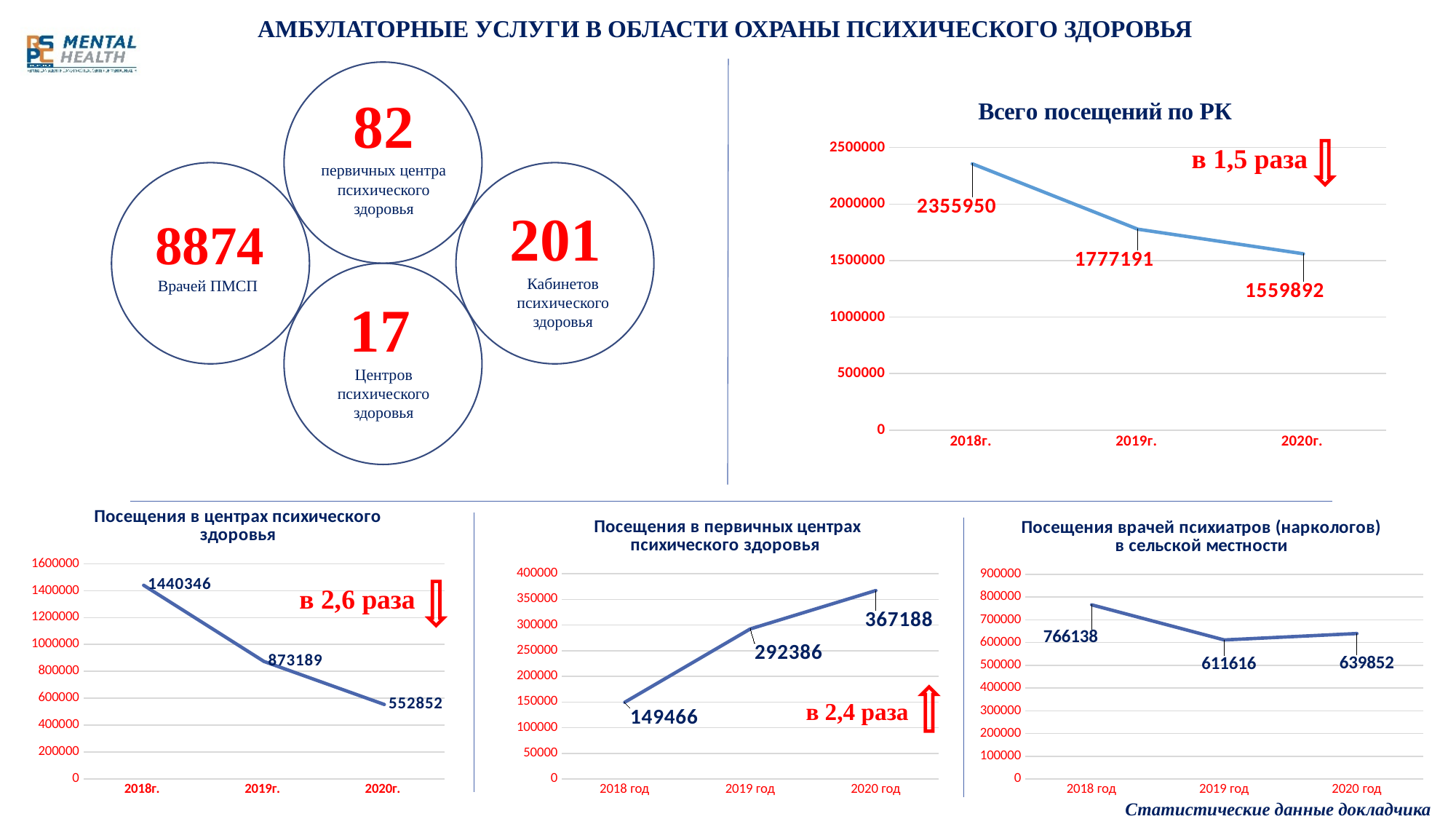
In the chart 'Всего посещений по РК', what is the value for 2018г.? 2355950 In the chart 'Посещения в центрах психического здоровья', what is the value for 2019г.? 873189 In the chart 'Всего посещений по РК', what is the value for 2020г.? 1559892 What kind of chart is 'Всего посещений по РК'? line chart In the chart 'Посещения в центрах психического здоровья', which year has the lowest value? 2020г. In the chart 'Посещения врачей психиатров (наркологов) в сельской местности', which is larger: the value for 2019 год or 2020 год? 2020 год In the chart 'Посещения в первичных центрах психического здоровья', what is the value for 2018 год? 149466 In the chart 'Посещения в первичных центрах психического здоровья', what is the difference between the 2020 год and 2018 год values? 217722 In the chart 'Всего посещений по РК', what is the difference between the 2018г. and 2020г. values? 796058 In the chart 'Посещения в первичных центрах психического здоровья', do the values rise or fall from 2018 год to 2020 год? rise In the chart 'Посещения врачей психиатров (наркологов) в сельской местности', which year has the highest value? 2018 год In the chart 'Всего посещений по РК', do the values rise or fall from 2018г. to 2020г.? fall